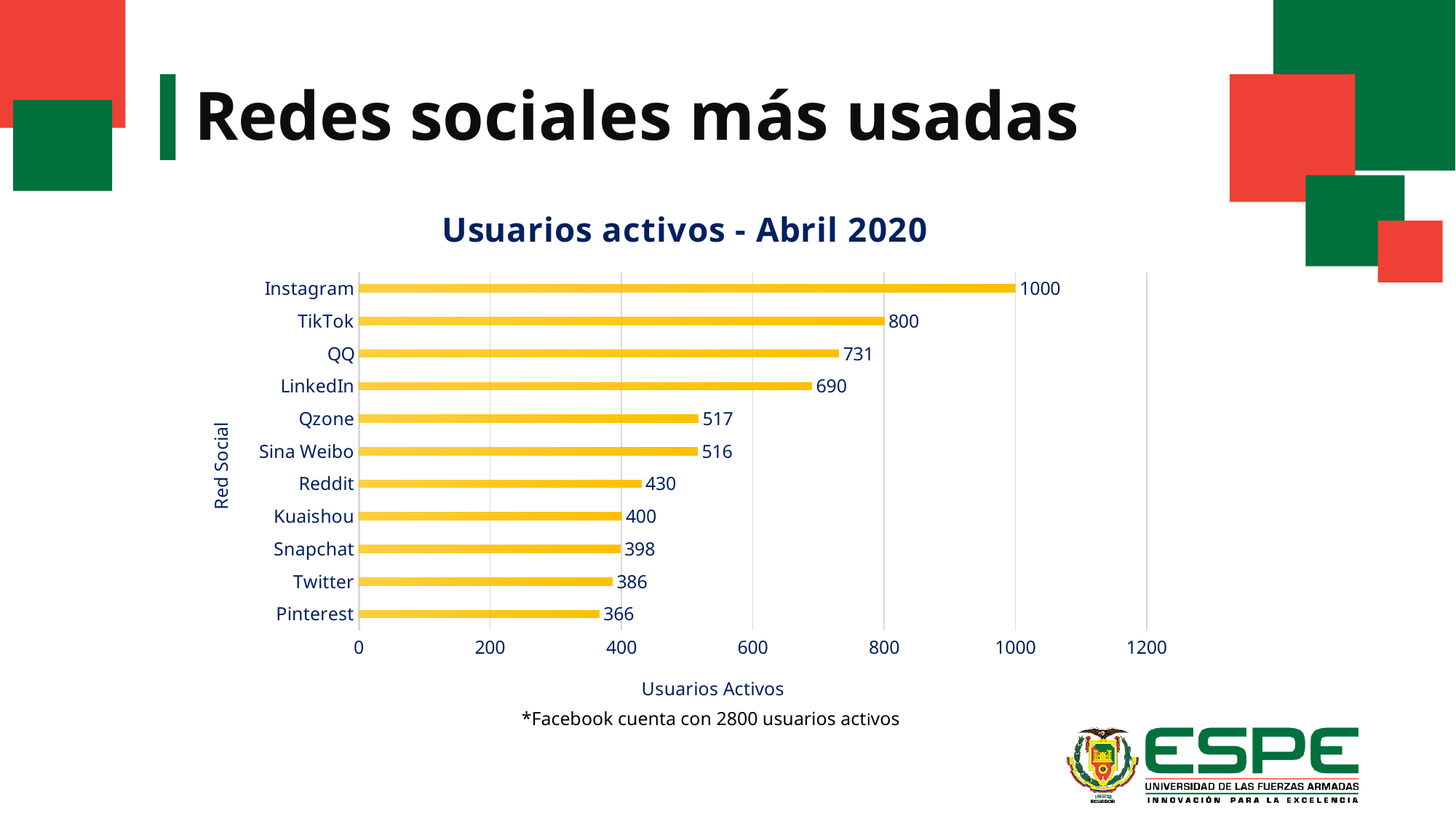
What is the difference between the values for TikTok and QQ? 69 Which has a larger value, LinkedIn or Qzone? LinkedIn What is the value for Instagram? 1000 Which social network has the lowest number of active users? Pinterest What is the value for LinkedIn? 690 Is the value for Kuaishou greater or less than 600? less What is the difference between the values for Reddit and Pinterest? 64 What is the title of the chart? Usuarios activos - Abril 2020 How many social networks are shown in the chart? 11 What is the value for Snapchat? 398 Which social network has the highest number of active users? Instagram What kind of chart is shown on the slide? bar chart